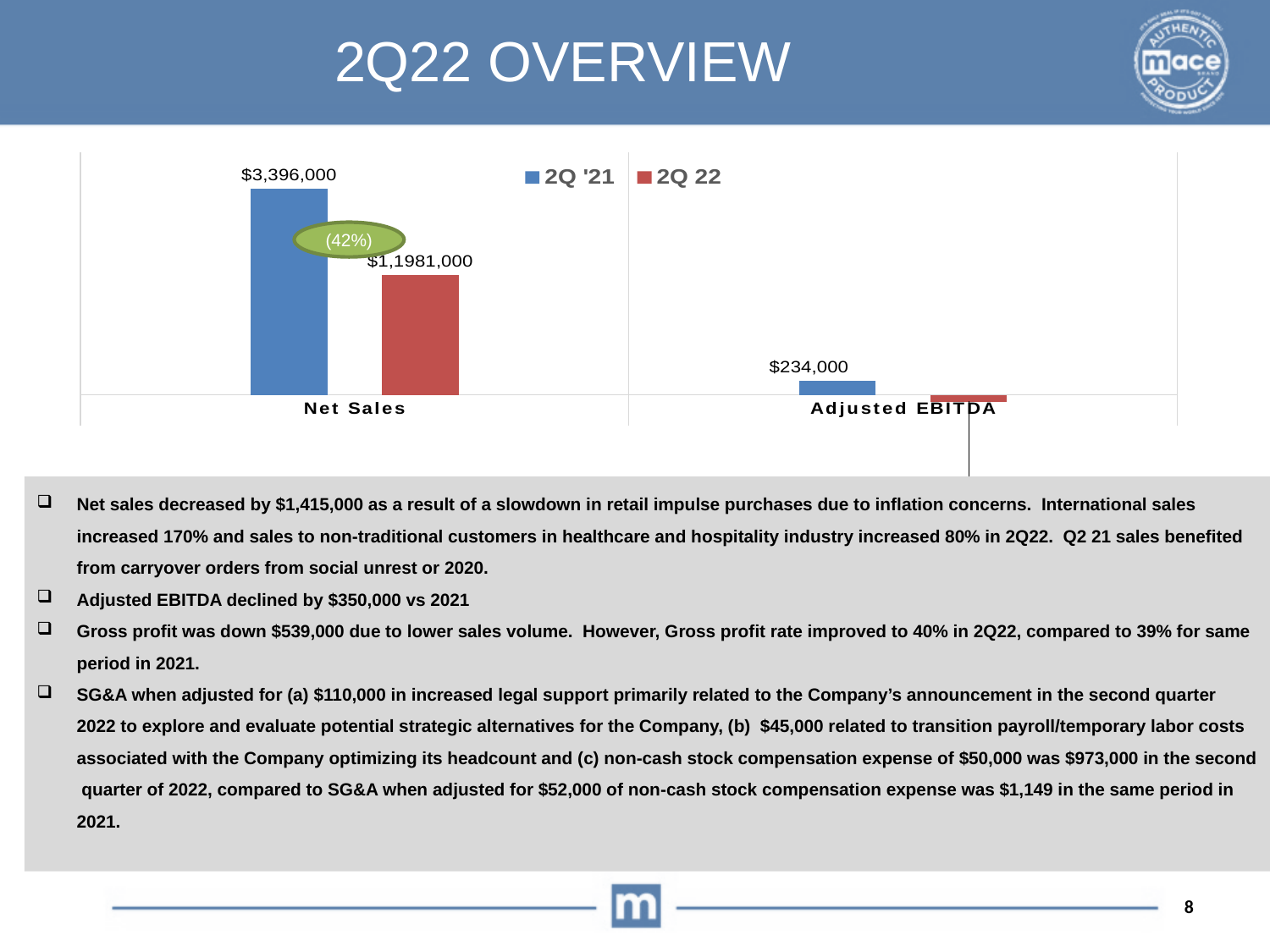
Which is larger, Net Sales for 2Q '21 or Net Sales for 2Q 22? 2Q '21 What are the two series named in the chart legend? 2Q '21 and 2Q 22 How many categories are shown on the x axis of the chart? 2 How many series does the chart legend list? 2 What kind of chart is shown on the slide? Bar chart Which is larger, Adjusted EBITDA for 2Q '21 or Adjusted EBITDA for 2Q 22? 2Q '21 What percentage is shown in the oval annotation between the Net Sales bars? (42%) Is the Adjusted EBITDA bar for 2Q 22 above or below zero? Below What is the Net Sales value for 2Q '21? $3,396,000 What is the Adjusted EBITDA value for 2Q '21? $234,000 Which bar in the chart is the tallest? Net Sales, 2Q '21